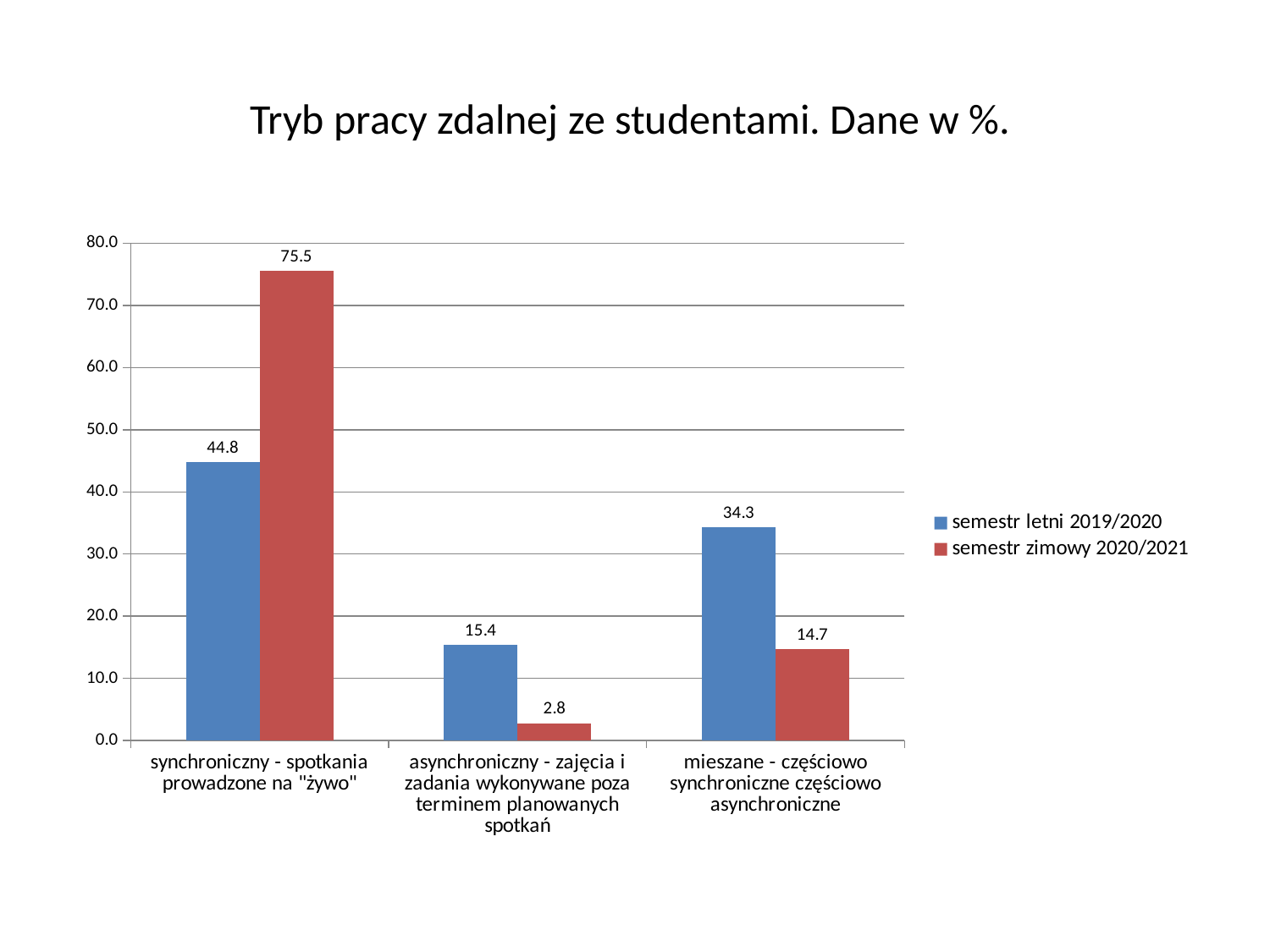
How many categories are shown on the x axis? 3 What is the value for 'synchroniczny - spotkania prowadzone na "żywo"' in the 'semestr zimowy 2020/2021' series? 75.5 Is the 'semestr letni 2019/2020' value for 'synchroniczny - spotkania prowadzone na "żywo"' greater or less than 40.0? greater Which category has the highest value in the 'semestr letni 2019/2020' series? synchroniczny - spotkania prowadzone na "żywo" Which is larger for 'mieszane - częściowo synchroniczne częściowo asynchroniczne': the 'semestr letni 2019/2020' value or the 'semestr zimowy 2020/2021' value? semestr letni 2019/2020 What is the value for 'asynchroniczny - zajęcia i zadania wykonywane poza terminem planowanych spotkań' in the 'semestr letni 2019/2020' series? 15.4 How many series does the legend list? 2 What kind of chart is shown on the slide? bar chart What is the title of the chart? Tryb pracy zdalnej ze studentami. Dane w %. Which category has the lowest value in the 'semestr zimowy 2020/2021' series? asynchroniczny - zajęcia i zadania wykonywane poza terminem planowanych spotkań What is the difference between the 'semestr zimowy 2020/2021' and 'semestr letni 2019/2020' values for 'synchroniczny - spotkania prowadzone na "żywo"'? 30.7 What is the value for 'mieszane - częściowo synchroniczne częściowo asynchroniczne' in the 'semestr zimowy 2020/2021' series? 14.7